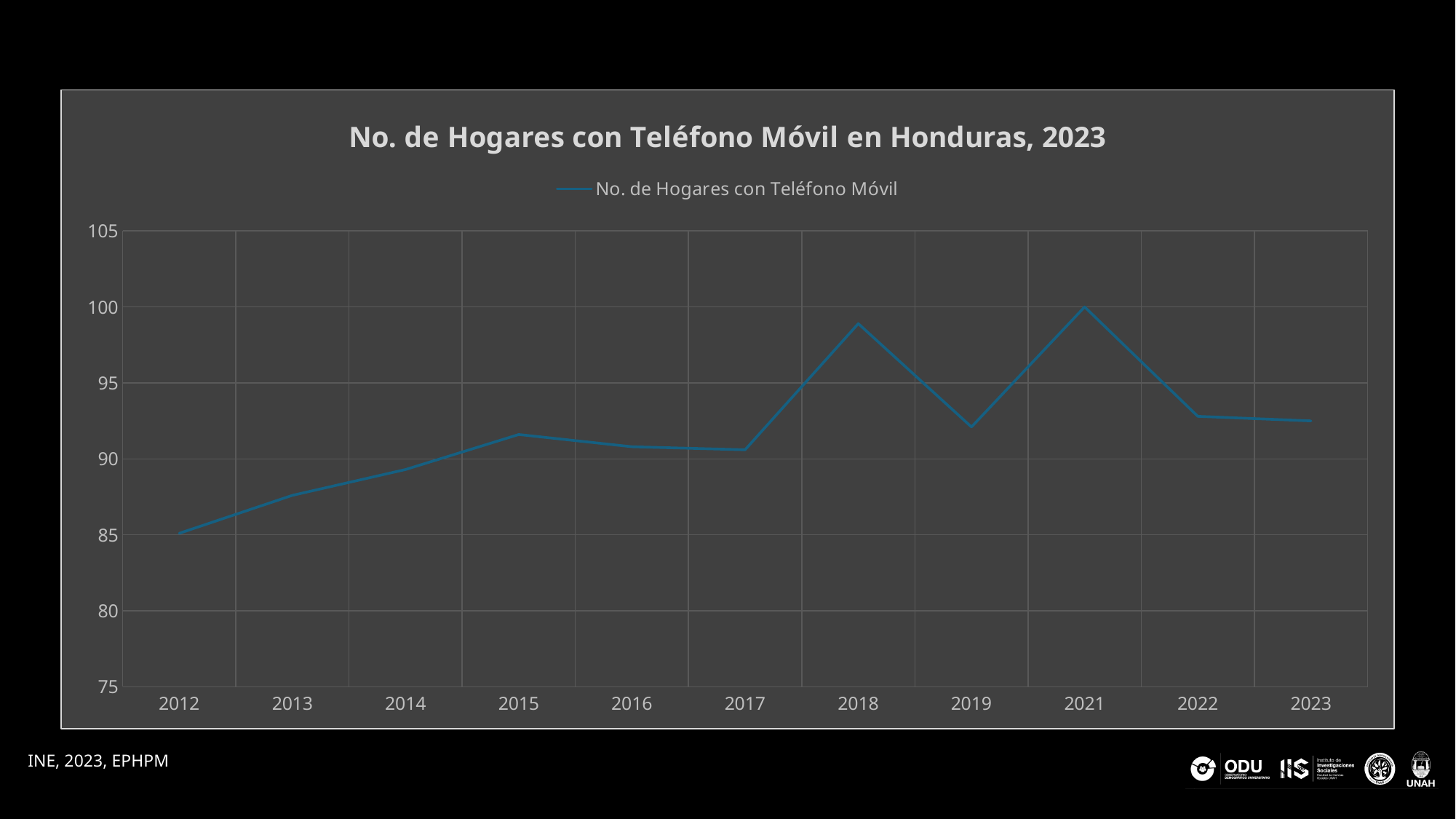
Which is larger, the value for 2018 or the value for 2019? 2018 What is the title of the chart? No. de Hogares con Teléfono Móvil en Honduras, 2023 Is the value for 2012 greater or less than 90? less How many series does the legend list? 1 How many years are plotted along the x axis? 11 Is the value for 2019 greater or less than 95? less Do the values rise or fall from 2012 to 2015? rise Is the value for 2018 greater or less than 95? greater Which year has the highest value? 2021 What kind of chart is shown on the slide? line chart Which year has the lowest value? 2012